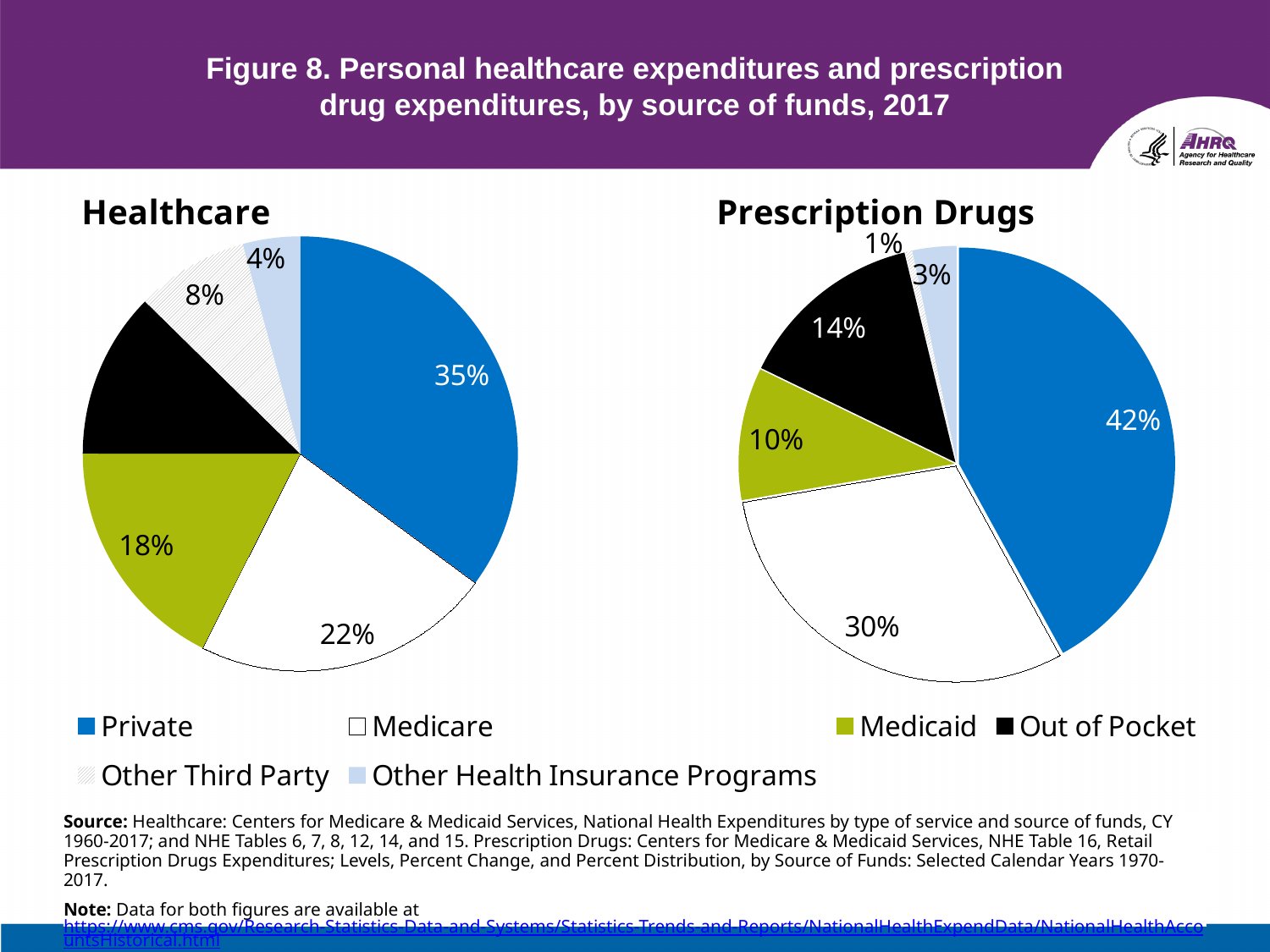
In the Healthcare pie chart, what share of expenditures comes from Medicare? 22% What kind of charts are shown on the slide? Pie charts In the Healthcare pie chart, which is larger, the Medicare share or the Medicaid share? Medicare In the Prescription Drugs pie chart, what share of expenditures comes from Out of Pocket? 14% In the Healthcare pie chart, what share of expenditures comes from Medicaid? 18% In the Healthcare pie chart, what share of expenditures comes from Private funds? 35% How many sources of funds does the legend list? 6 In the Prescription Drugs pie chart, which source of funds has the smallest share? Other Third Party In the Prescription Drugs pie chart, what share of expenditures comes from Private funds? 42% In the Prescription Drugs pie chart, what share of expenditures comes from Medicaid? 10% In the Prescription Drugs pie chart, which source of funds has the largest share? Private In the Prescription Drugs pie chart, what is the difference in percentage points between the Private and Medicare shares? 12